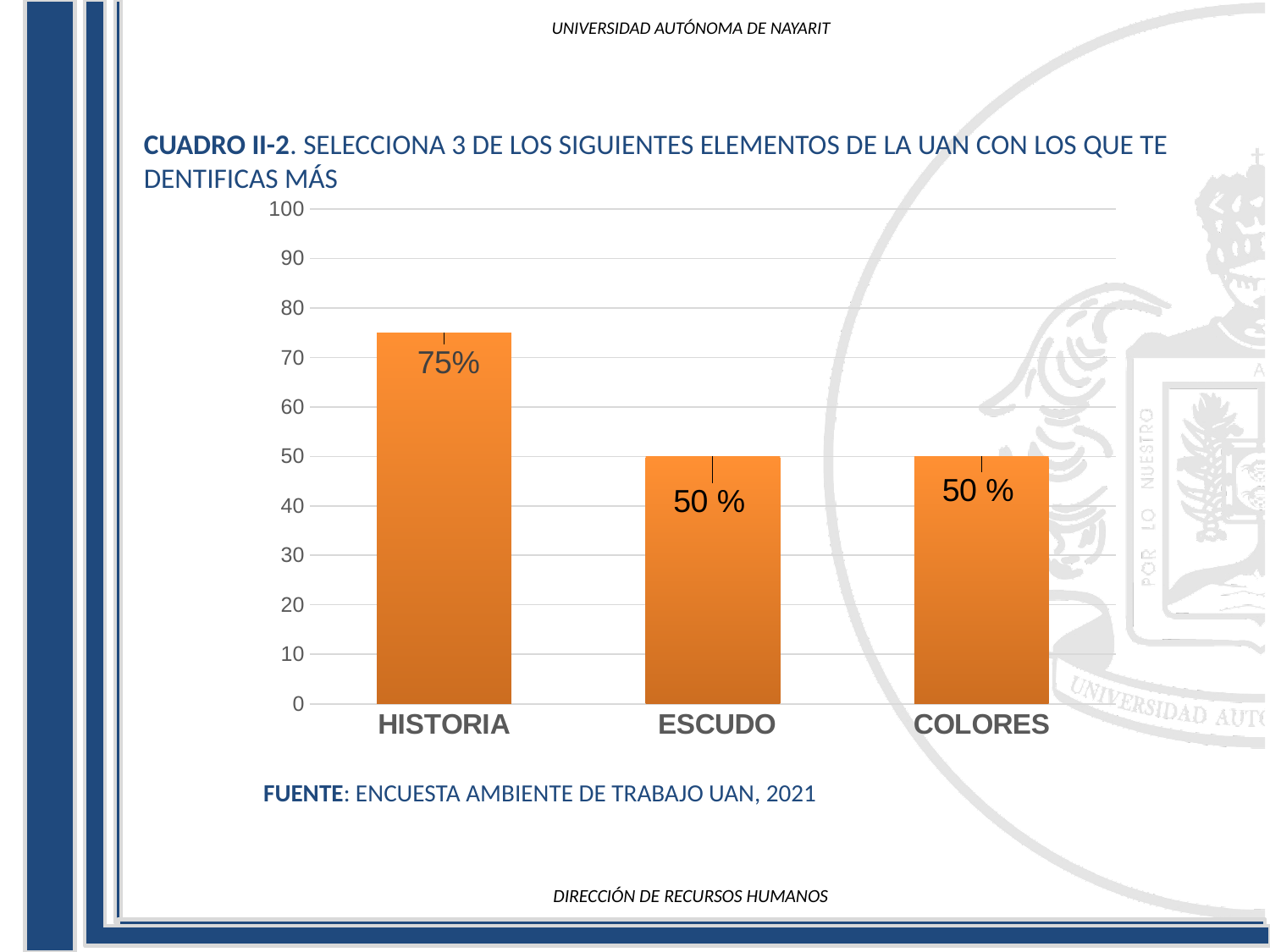
What is the maximum value shown on the y axis? 100 Is the value for ESCUDO greater or less than 60? less Is the value for HISTORIA greater or less than 70? greater What is the value for ESCUDO? 50 % What kind of chart is shown on the slide? bar chart What source is cited below the chart? ENCUESTA AMBIENTE DE TRABAJO UAN, 2021 What is the value for HISTORIA? 75% What is the value for COLORES? 50 % What is the difference between the values for HISTORIA and ESCUDO? 25% Which is larger, the value for HISTORIA or the value for COLORES? HISTORIA How many categories are shown on the x axis? 3 Which category has the highest value? HISTORIA